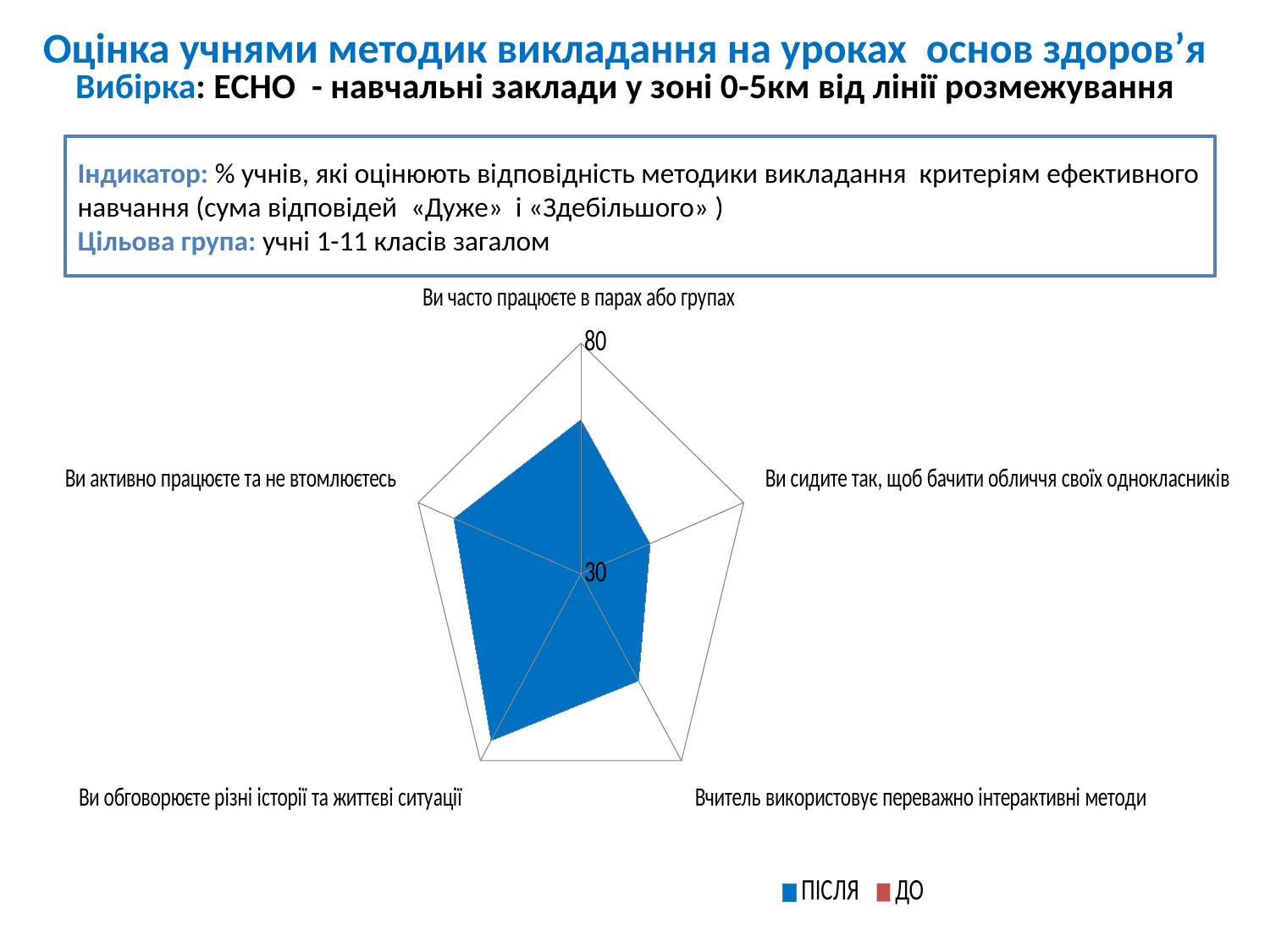
Which is larger: the value for "Ви часто працюєте в парах або групах" or for "Ви сидите так, щоб бачити обличчя своїх однокласників"? Ви часто працюєте в парах або групах Which is larger: the value for "Вчитель використовує переважно інтерактивні методи" or for "Ви сидите так, щоб бачити обличчя своїх однокласників"? Вчитель використовує переважно інтерактивні методи Which category has the highest value on the chart? Ви обговорюєте різні історії та життєві ситуації How many series does the legend of the chart list? 2 Is the value for "Вчитель використовує переважно інтерактивні методи" greater or less than 80? less What kind of chart is shown on the slide? radar chart Which series is shown in blue on the chart? ПІСЛЯ What are the two series named in the chart legend? ПІСЛЯ and ДО How many categories (axes) does the radar chart have? 5 Which category has the lowest value on the chart? Ви сидите так, щоб бачити обличчя своїх однокласників Is the value for "Ви часто працюєте в парах або групах" greater or less than 80? less Is the value for "Ви сидите так, щоб бачити обличчя своїх однокласників" greater or less than 80? less